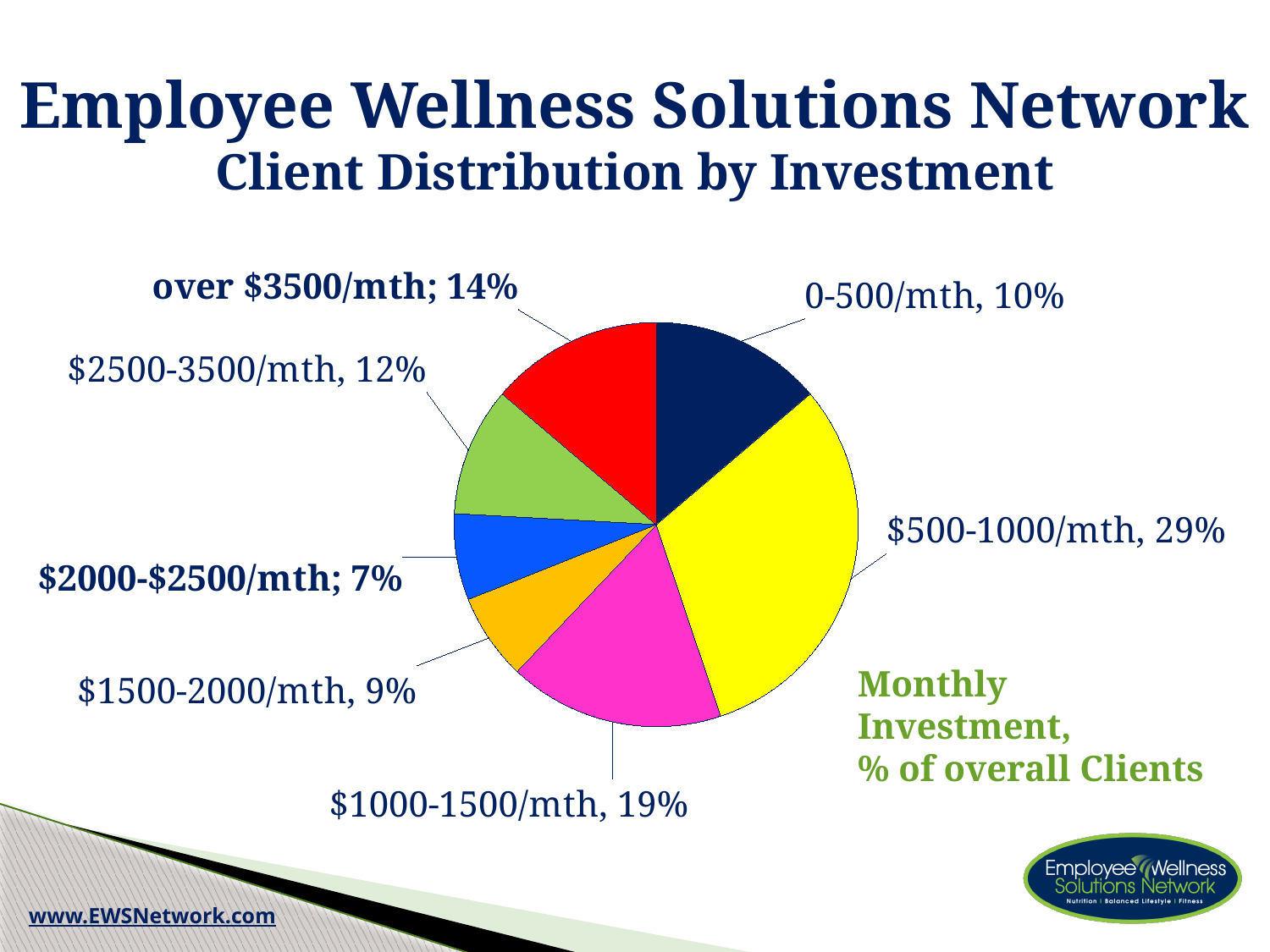
Which investment range has the smallest share of clients? $2000-$2500/mth What kind of chart is shown on the slide? pie chart Which is larger: the share for $2500-3500/mth or the share for 0-500/mth? $2500-3500/mth Which investment range has the largest share of clients? $500-1000/mth What percentage of clients invest $500-1000/mth? 29% What is the difference between the share for $500-1000/mth and the share for $1000-1500/mth? 10% How many investment ranges (slices) does the pie chart show? 7 What colour is the slice for $500-1000/mth? yellow What percentage of clients invest $2000-$2500/mth? 7% What is the combined share of clients investing $1500-2000/mth and $2000-$2500/mth? 16% What percentage of clients invest over $3500/mth? 14% What percentage of clients invest $1000-1500/mth? 19%